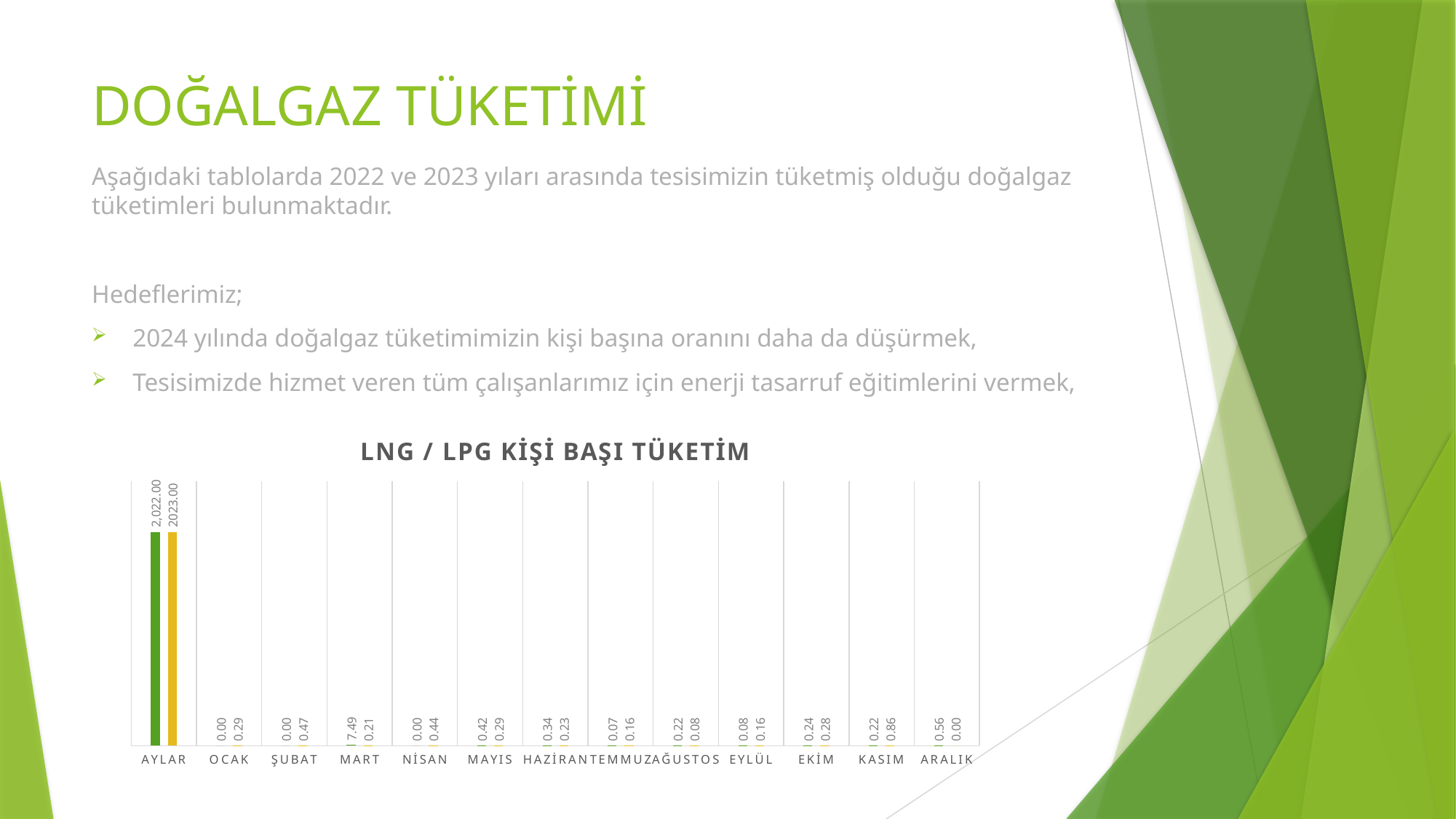
What value is printed on the yellow (second) bar for KASIM? 0.86 For KASIM, which bar has the larger value, the green (first) or the yellow (second)? yellow (second) What is the difference between the yellow and green bar values for KASIM? 0.64 What kind of chart is shown on the slide? bar chart What value is printed on the green (first) bar for MART? 7.49 What value is printed on the green (first) bar for ARALIK? 0.56 How many month names appear on the x axis of the chart? 12 What is the title of the chart? LNG / LPG KİŞİ BAŞI TÜKETİM What value is printed on the yellow (second) bar for ŞUBAT? 0.47 What is the difference between the green and yellow bar values for MART? 7.28 Among the month categories (OCAK to ARALIK), which has the highest green (first) bar value? MART What value is printed on the green (first) bar in the AYLAR category? 2,022.00